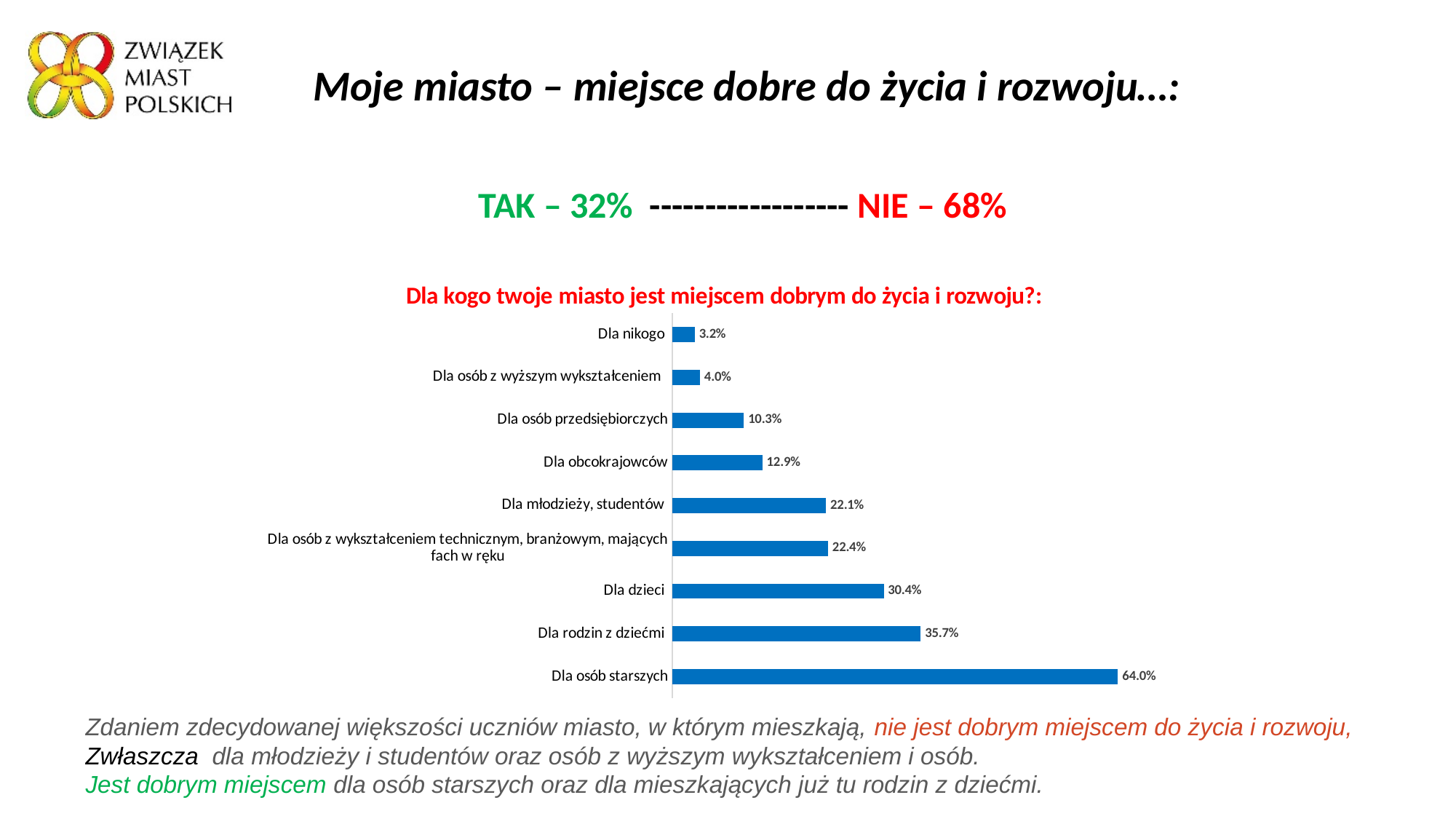
What is the title of the chart? Dla kogo twoje miasto jest miejscem dobrym do życia i rozwoju?: Which category has the lowest value? Dla nikogo What is the value for "Dla młodzieży, studentów"? 22.1% What is the value for "Dla rodzin z dziećmi"? 35.7% What is the difference between the values for "Dla dzieci" and "Dla osób z wykształceniem technicznym, branżowym, mających fach w ręku"? 8.0 percentage points What is the value for "Dla osób starszych"? 64.0% How many categories are shown in the chart? 9 What is the difference between the values for "Dla osób starszych" and "Dla rodzin z dziećmi"? 28.3 percentage points What kind of chart is shown on the slide? Bar chart Which is larger: the value for "Dla osób przedsiębiorczych" or for "Dla obcokrajowców"? Dla obcokrajowców What is the value for "Dla obcokrajowców"? 12.9% Which category has the highest value? Dla osób starszych